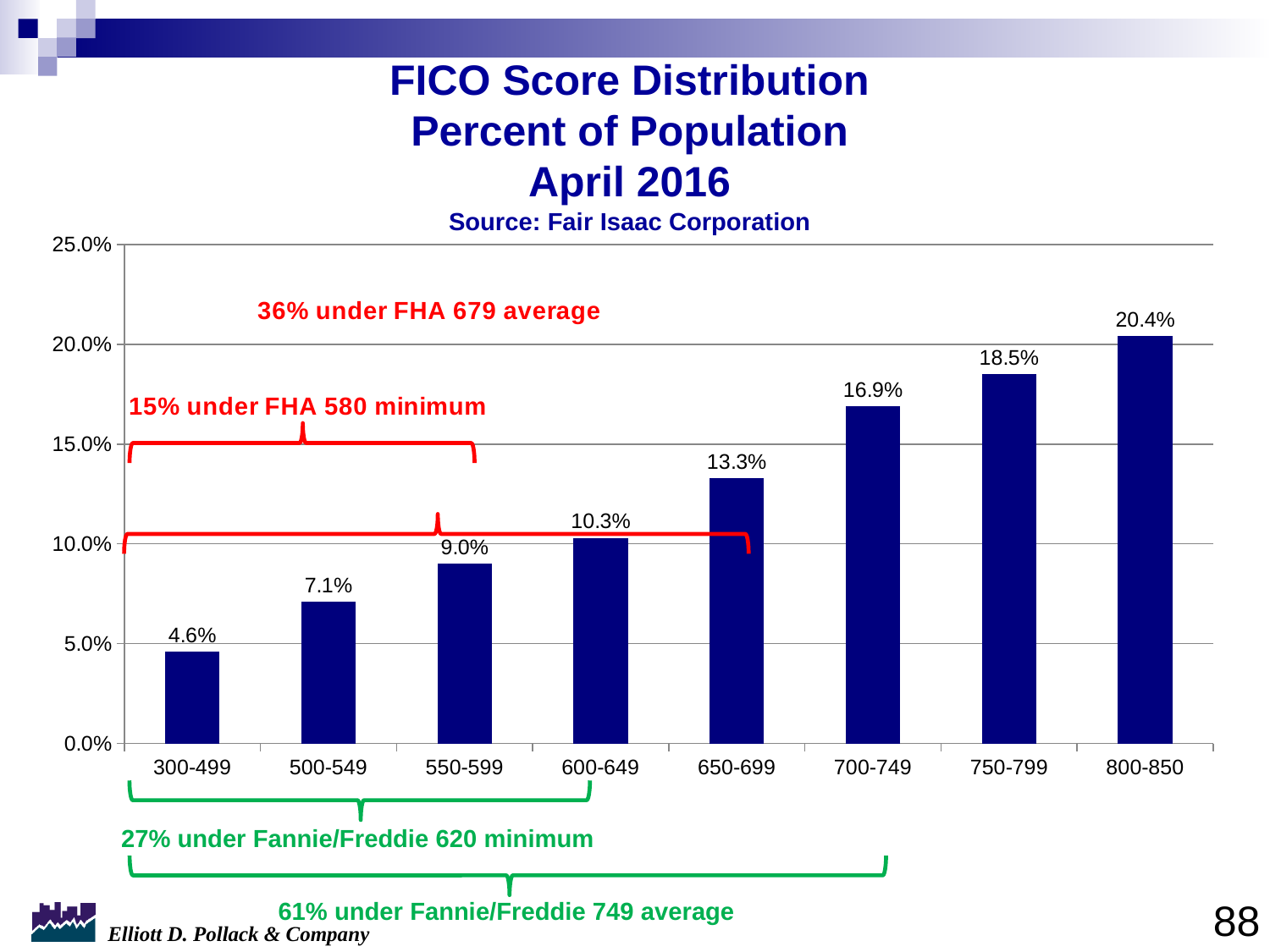
What is the difference between the values for 800-850 and 700-749? 3.5% Do the values rise or fall as the FICO score ranges increase along the x axis? rise Which is larger, the value for 550-599 or the value for 600-649? 600-649 What percent of the population has a FICO score of 300-499? 4.6% What is the value for the 750-799 FICO score range? 18.5% Which FICO score range has the highest percent of population? 800-850 Which FICO score range has the lowest percent of population? 300-499 How many FICO score ranges are shown on the x axis? 8 Is the value for 700-749 greater or less than 15.0%? greater According to the slide, what is the source of the FICO score distribution data? Fair Isaac Corporation What is the value for the 650-699 FICO score range? 13.3% What kind of chart is shown on the slide? bar chart